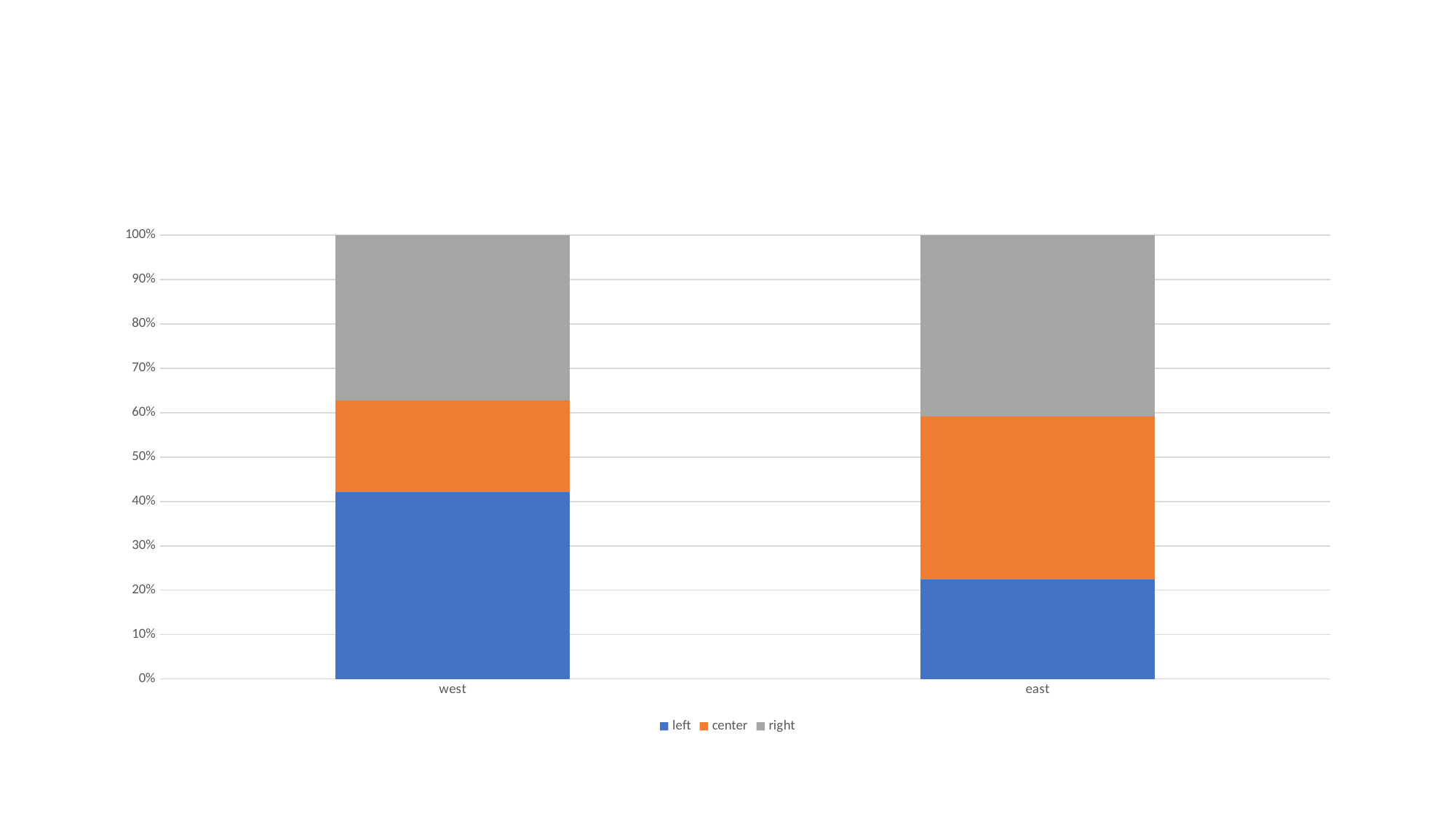
How many categories are shown on the x axis? 2 What are the series names listed in the legend? left, center, right Is the 'center' segment larger for west or for east? east Is the value for 'left' in east greater or less than 30%? less Is the 'left' segment larger for west or for east? west Which colour represents the 'left' series? blue Which category has the largest 'left' segment? west Is the value for 'left' in west greater or less than 30%? greater How many series does the legend list? 3 What is the total height of the stacked bar for west? 100% What kind of chart is shown on the slide? bar chart What is the total height of the stacked bar for east? 100%